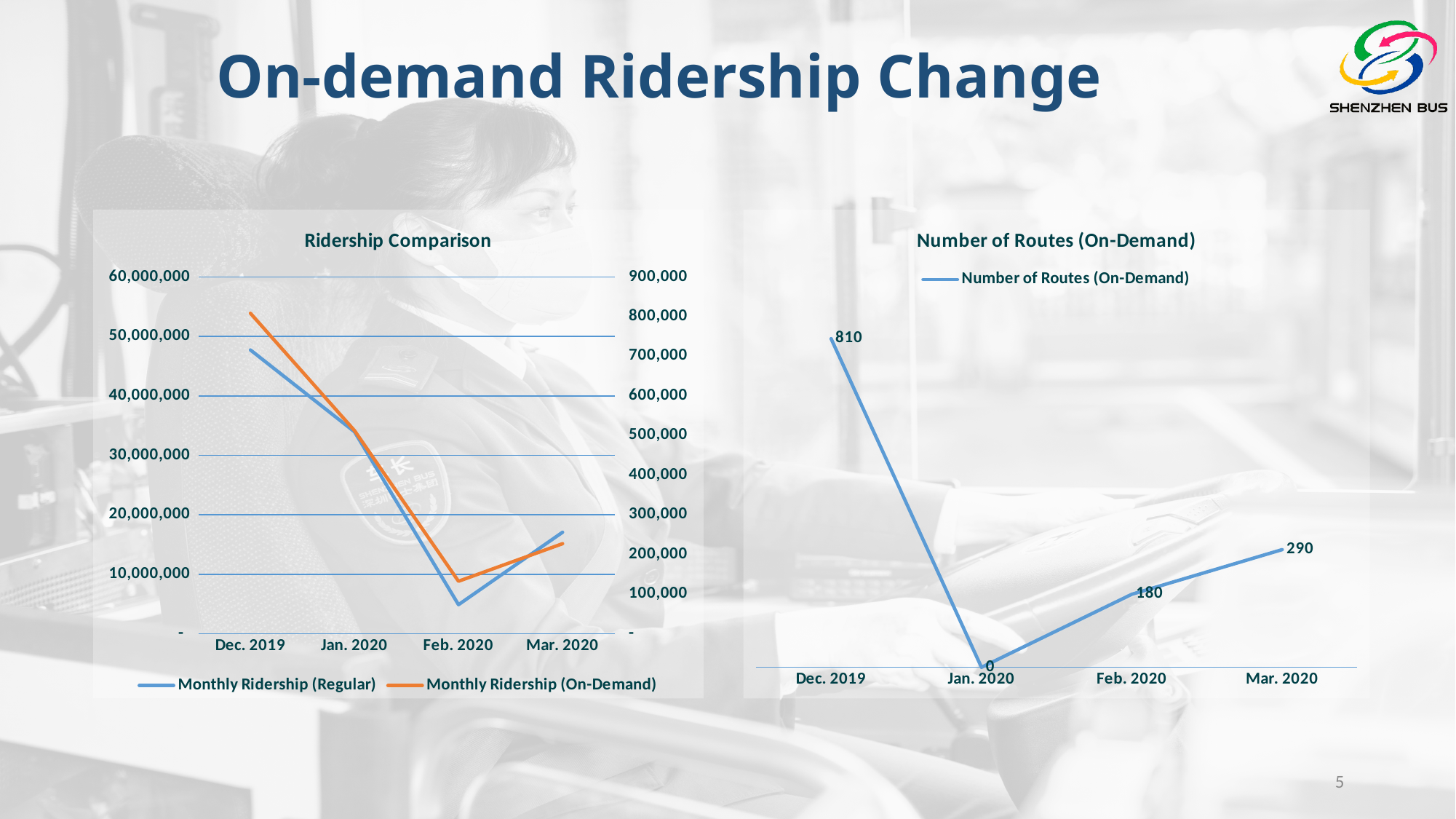
In the 'Number of Routes (On-Demand)' chart, do the values rise or fall from Jan. 2020 to Mar. 2020? rise In the 'Number of Routes (On-Demand)' chart, what is the difference between the values for Mar. 2020 and Feb. 2020? 110 In the 'Ridership Comparison' chart, is the Monthly Ridership (Regular) for Dec. 2019 greater or less than 40,000,000? greater In the 'Number of Routes (On-Demand)' chart, which month has the lowest number of routes? Jan. 2020 In the 'Ridership Comparison' chart, which month has the lowest Monthly Ridership (Regular)? Feb. 2020 How many series does the legend of the 'Ridership Comparison' chart list? 2 In the 'Number of Routes (On-Demand)' chart, what is the value for Mar. 2020? 290 In the 'Number of Routes (On-Demand)' chart, what is the value for Dec. 2019? 810 In the 'Ridership Comparison' chart, is the Monthly Ridership (Regular) for Feb. 2020 greater or less than 10,000,000? less In the 'Number of Routes (On-Demand)' chart, what is the value for Jan. 2020? 0 What kind of chart is the 'Ridership Comparison' chart? line chart In the 'Number of Routes (On-Demand)' chart, how many months are plotted on the x axis? 4